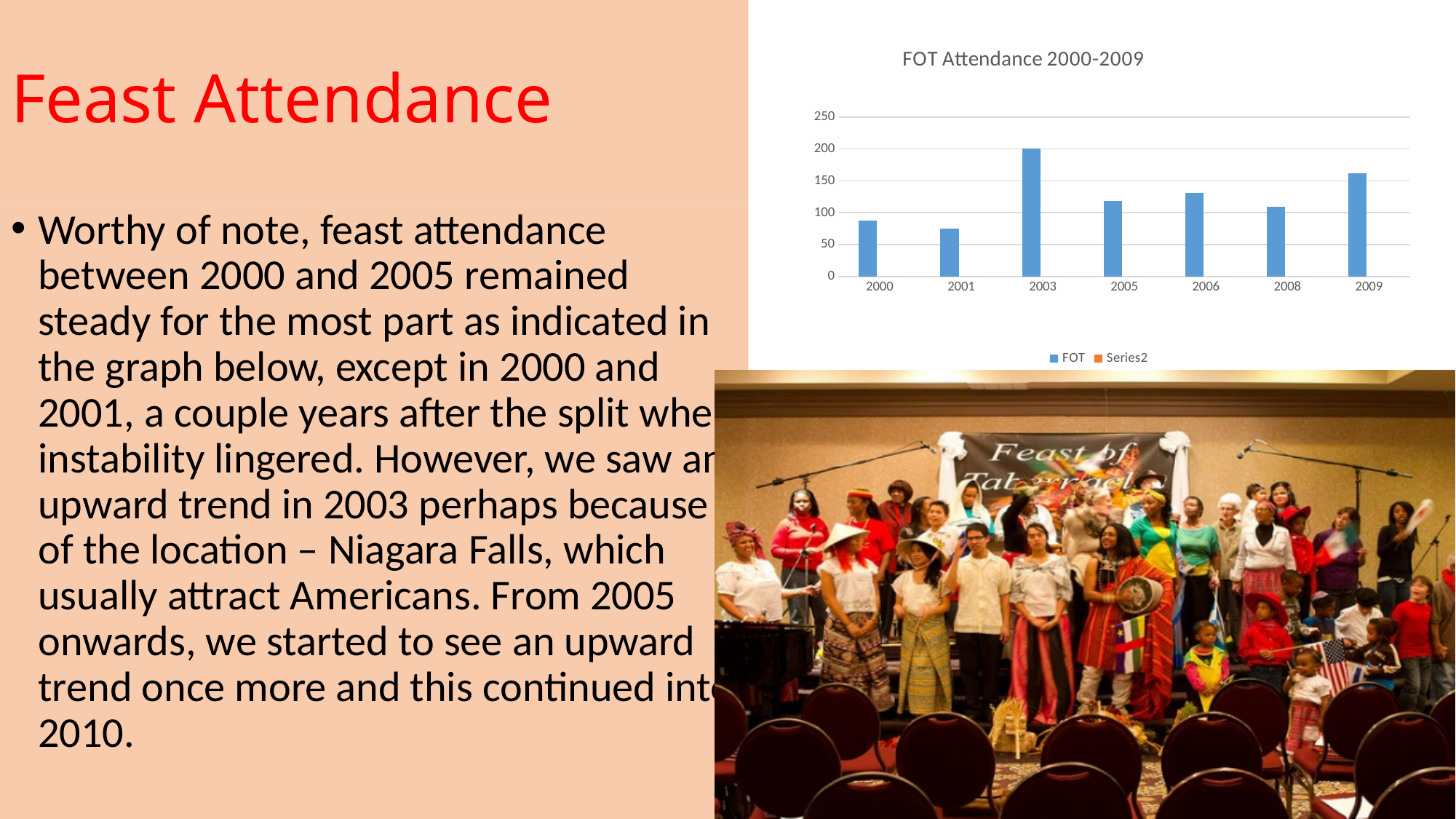
How many series does the chart legend list? 2 Which year has higher attendance, 2000 or 2001? 2000 What kind of chart is shown on the slide? bar chart Which year has the highest attendance in the chart? 2003 Is the attendance for 2005 greater or less than 100? greater Which year has the lowest attendance in the chart? 2001 Is the attendance for 2009 greater or less than 150? greater What is the title of the chart? FOT Attendance 2000-2009 How many years are shown on the x axis of the chart? 7 Is the attendance for 2001 greater or less than 100? less Which year has higher attendance, 2009 or 2008? 2009